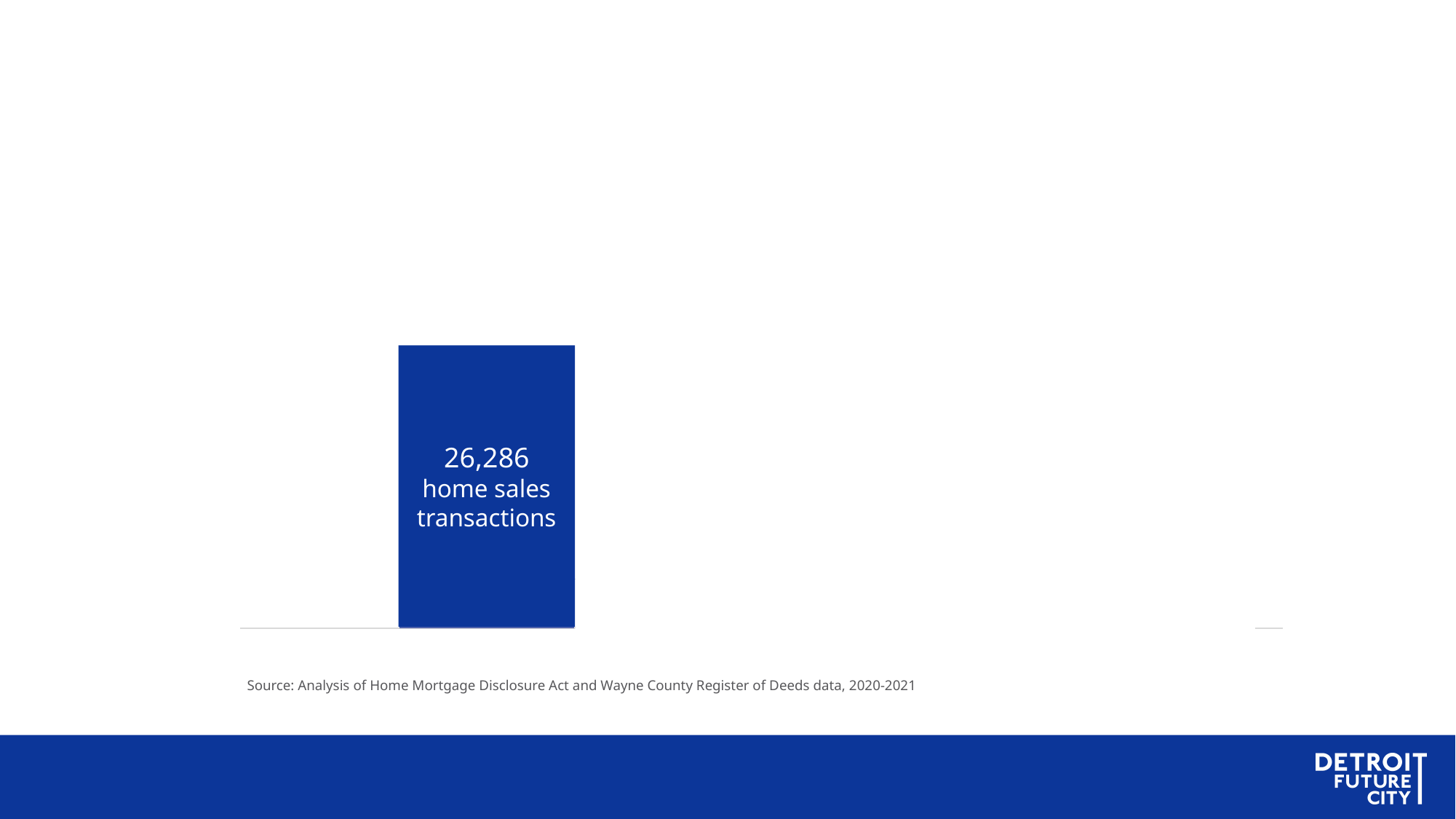
What value is printed on the blue bar? 26,286 According to the source note, what years does the data cover? 2020-2021 How many bars are plotted on the chart? 1 What does the label on the bar say the 26,286 figure represents? home sales transactions What colour is the bar on the chart? blue What kind of chart is shown on the slide? bar chart